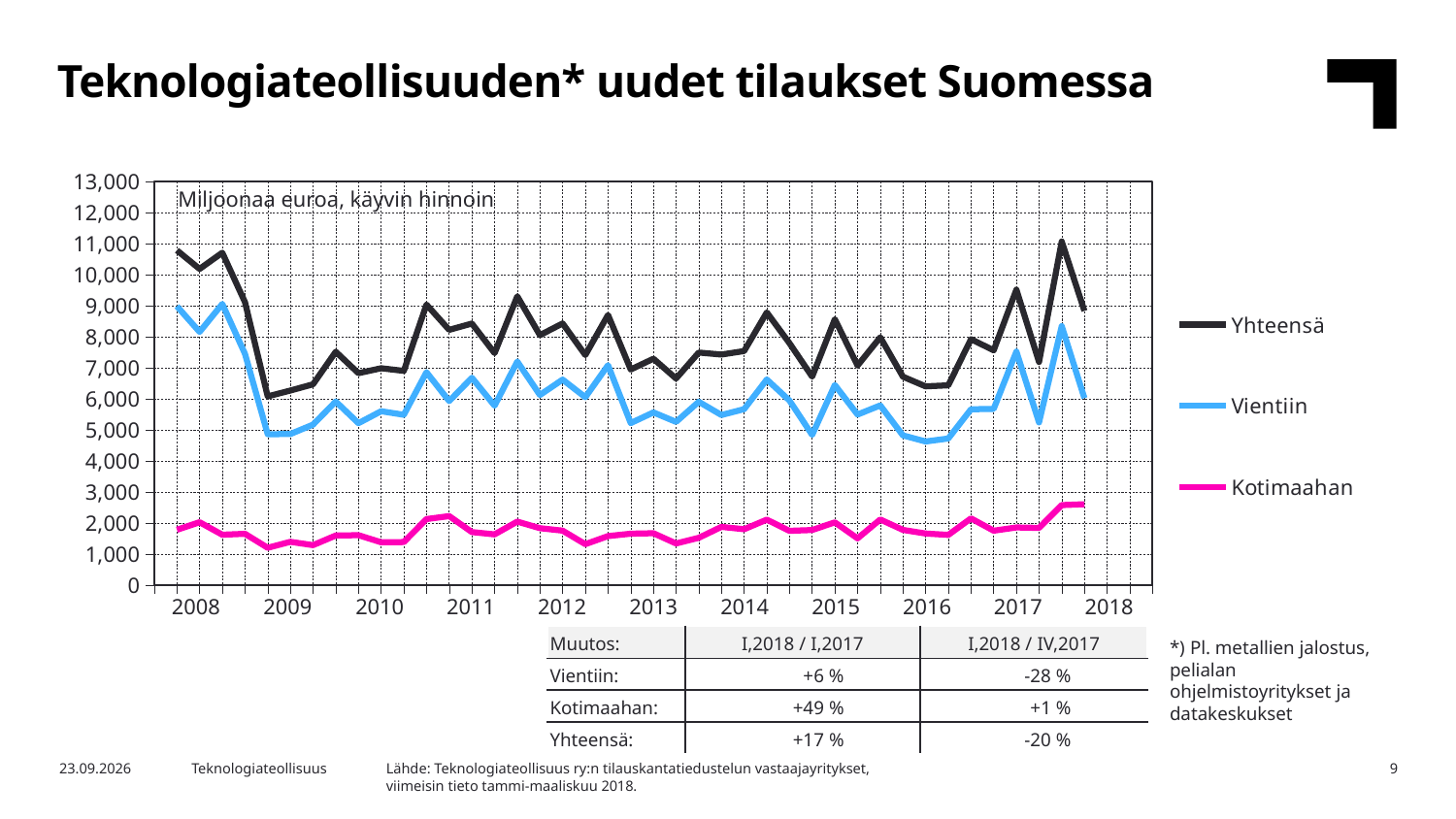
Which series has the highest values across the whole chart? Yhteensä Is the value for Vientiin in 2016 greater or less than 6,000? less Which series is plotted with the black line? Yhteensä Is the value for Kotimaahan at the start of 2018 greater or less than 3,000? less What unit note is printed inside the plot area of the chart? Miljoonaa euroa, käyvin hinnoin What kind of chart is shown on the slide? Line chart How many series does the chart legend list? 3 How many year labels are shown on the x axis? 11 Does the Yhteensä line rise or fall from 2008 to 2009? Fall Which is larger at the start of 2018, Yhteensä or Vientiin? Yhteensä Which series has the lowest values across the whole chart? Kotimaahan Is the peak value for Yhteensä in 2017 greater or less than 10,000? greater